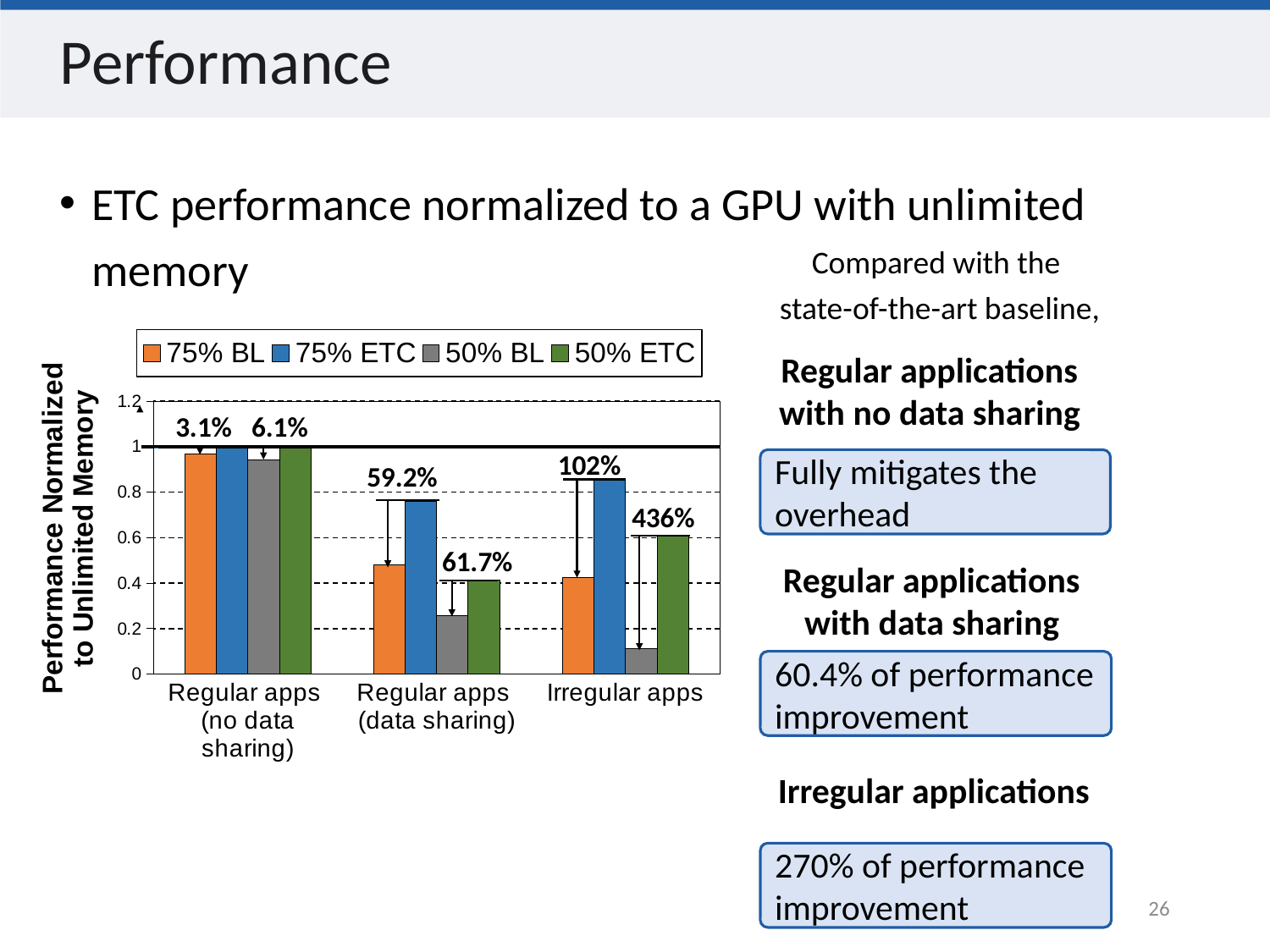
What is the title of the chart's y axis? Performance Normalized to Unlimited Memory In the Irregular apps category, which is larger: 75% BL or 75% ETC? 75% ETC Is the value for 75% ETC in the Regular apps (data sharing) category greater or less than 0.6? greater What percentage label is printed above the 50% ETC bar in the Irregular apps category? 436% How many application categories are shown on the x axis of the chart? 3 Is the value for 50% ETC in the Regular apps (data sharing) category greater or less than 0.6? less Which series has the highest value in the Regular apps (data sharing) category? 75% ETC Which series has the lowest value in the Irregular apps category? 50% BL How many series does the chart legend list? 4 Is the value for 50% BL in the Irregular apps category greater or less than 0.2? less In the Regular apps (data sharing) category, which is larger: 50% BL or 50% ETC? 50% ETC What kind of chart is shown on the slide? bar chart